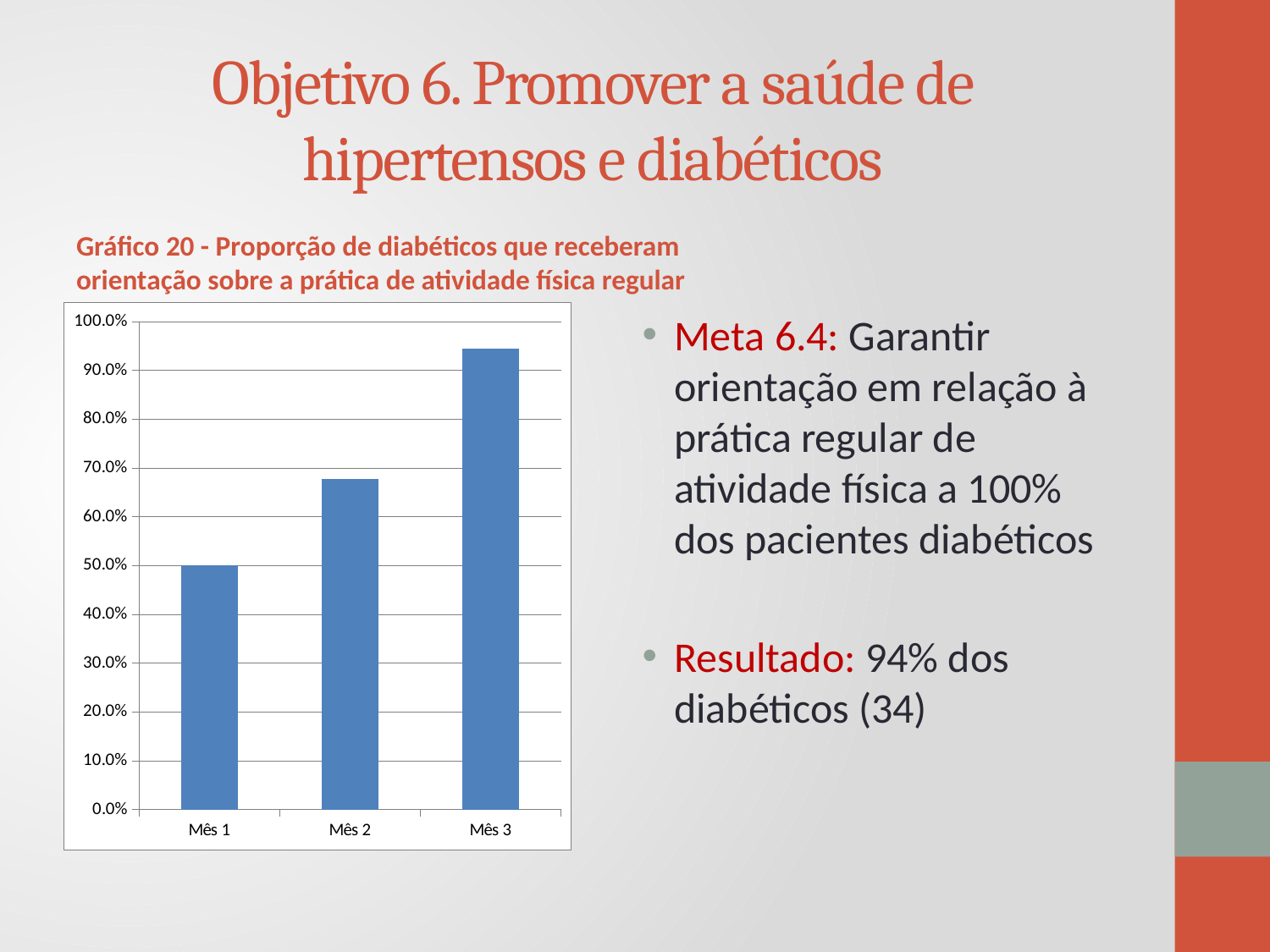
What kind of chart is shown on the slide? bar chart Which is larger, the value for Mês 2 or the value for Mês 3? Mês 3 Is the value for Mês 1 greater or less than 60.0%? less How many categories are plotted on the x axis of the chart? 3 What is the value for Mês 1 in the chart? 50.0% Which month has the lowest bar in the chart? Mês 1 What is the title of the chart on the slide? Gráfico 20 - Proporção de diabéticos que receberam orientação sobre a prática de atividade física regular Is the value for Mês 3 greater or less than 90.0%? greater Is the value for Mês 2 greater or less than 60.0%? greater Do the values rise or fall from Mês 1 to Mês 3? rise Which month has the highest bar in the chart? Mês 3